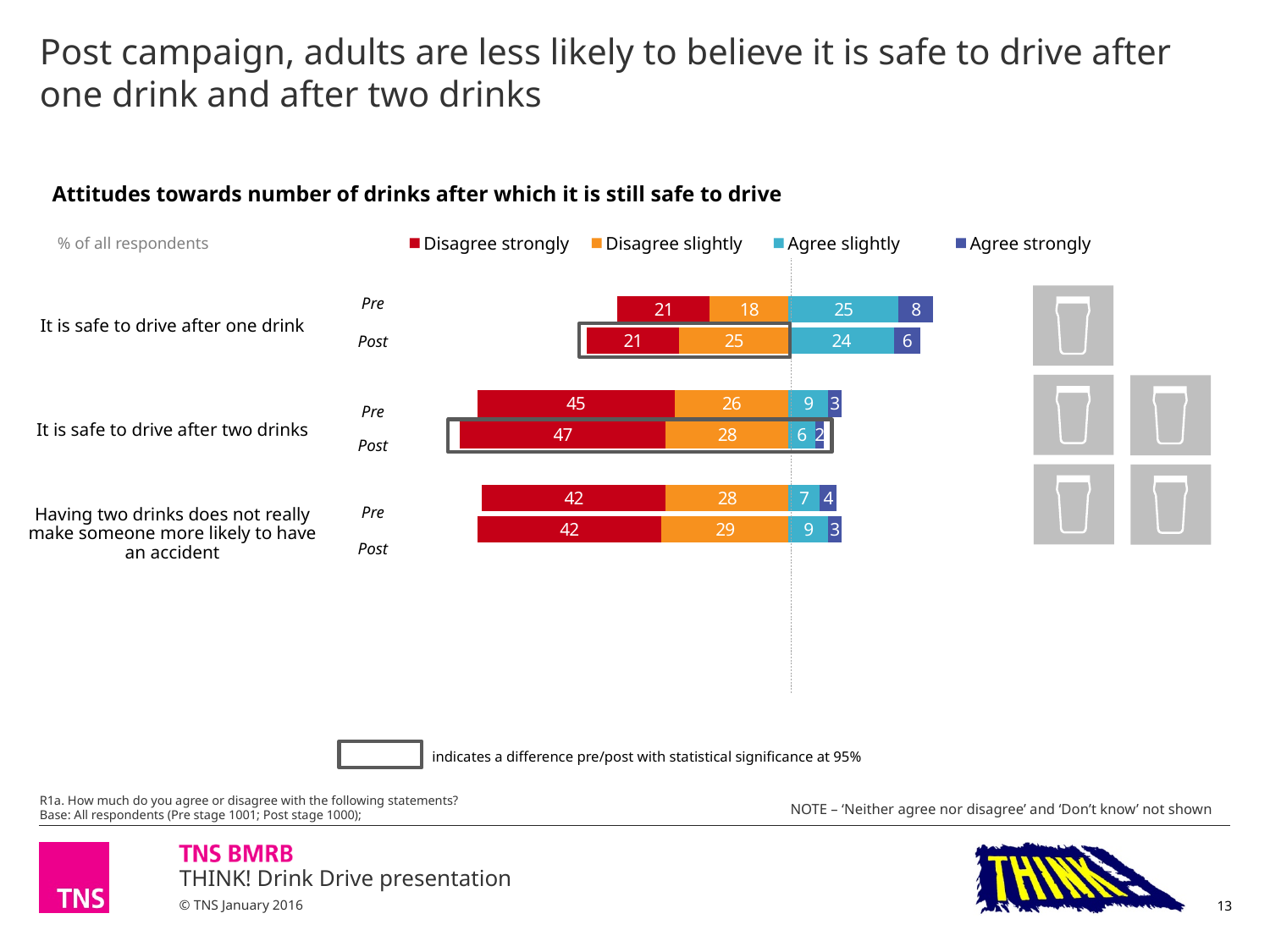
What is the 'Disagree slightly' value for 'It is safe to drive after one drink' at the Post stage? 25 What is the difference between the Pre and Post 'Disagree slightly' values for 'It is safe to drive after one drink'? 7 What is the 'Agree slightly' value for 'Having two drinks does not really make someone more likely to have an accident' at the Post stage? 9 What is the title of the chart? Attitudes towards number of drinks after which it is still safe to drive Which statement has the lowest 'Agree strongly' value at the Post stage? It is safe to drive after two drinks What kind of chart is shown on the slide? Stacked bar chart How many series does the legend list? 4 Is the Pre 'Agree slightly' value for 'It is safe to drive after one drink' larger or smaller than the Post value? Larger What is the 'Agree strongly' value for 'It is safe to drive after one drink' at the Pre stage? 8 What is the 'Disagree strongly' value for 'It is safe to drive after two drinks' at the Post stage? 47 What is the total of the four segments for 'It is safe to drive after two drinks' at the Post stage? 83 Which statement has the highest 'Disagree strongly' value at the Post stage? It is safe to drive after two drinks